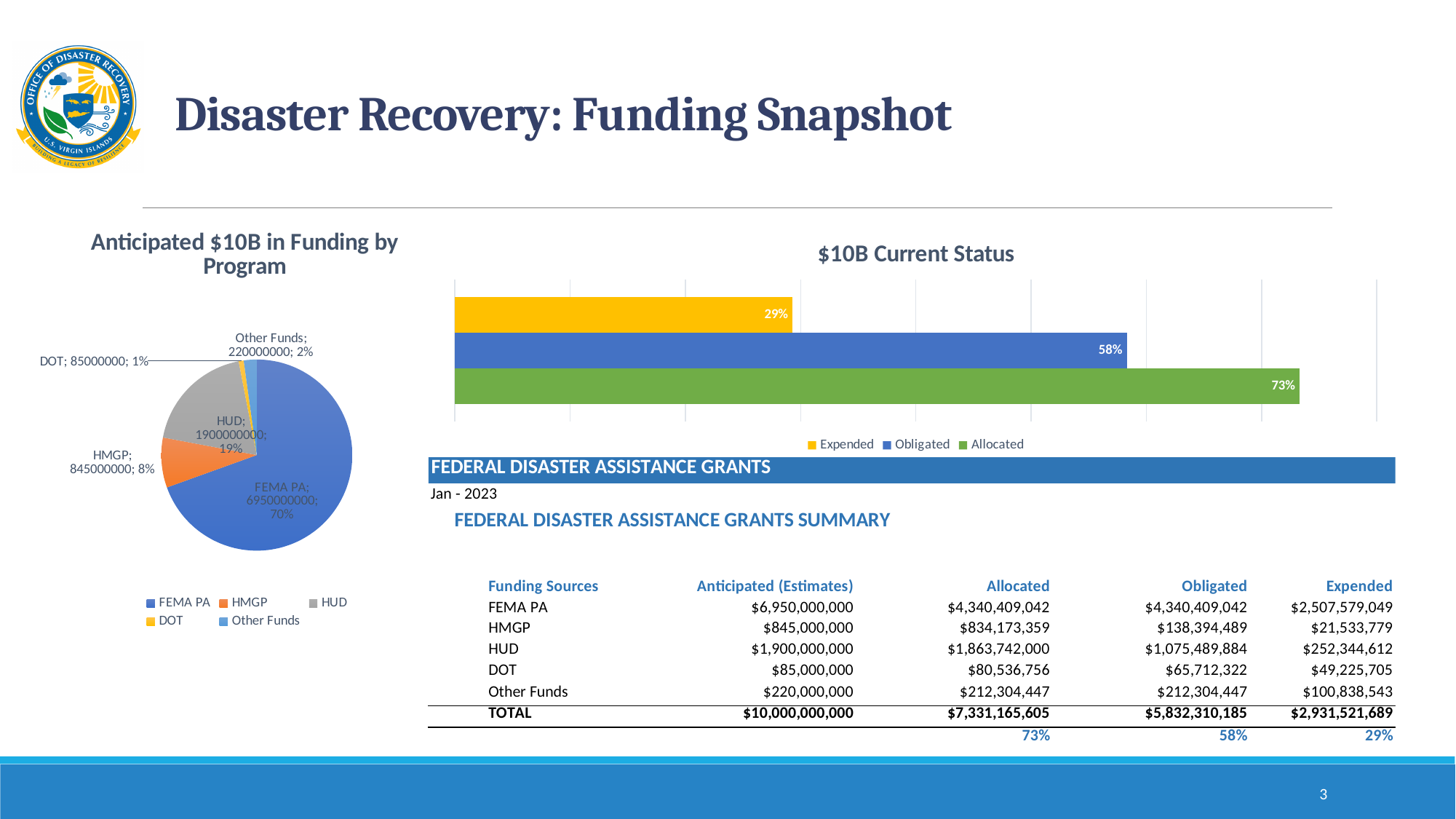
In the 'Anticipated $10B in Funding by Program' pie chart, what share does HMGP have? 8% How many series does the legend of the '$10B Current Status' chart list? 3 In the '$10B Current Status' chart, what is the difference between Allocated and Expended? 44% In the 'Anticipated $10B in Funding by Program' pie chart, which program has the smallest slice? DOT In the 'Anticipated $10B in Funding by Program' pie chart, what is the difference between the HUD value and the HMGP value? 1055000000 How many slices does the 'Anticipated $10B in Funding by Program' pie chart have? 5 In the '$10B Current Status' chart, what percentage is shown for Expended? 29% In the '$10B Current Status' chart, what percentage is shown for Obligated? 58% In the '$10B Current Status' chart, which series has the highest value? Allocated In the 'Anticipated $10B in Funding by Program' pie chart, which program has the largest slice? FEMA PA In the 'Anticipated $10B in Funding by Program' pie chart, what share does FEMA PA have? 70% In the 'Anticipated $10B in Funding by Program' pie chart, what value is shown for HUD? 1900000000